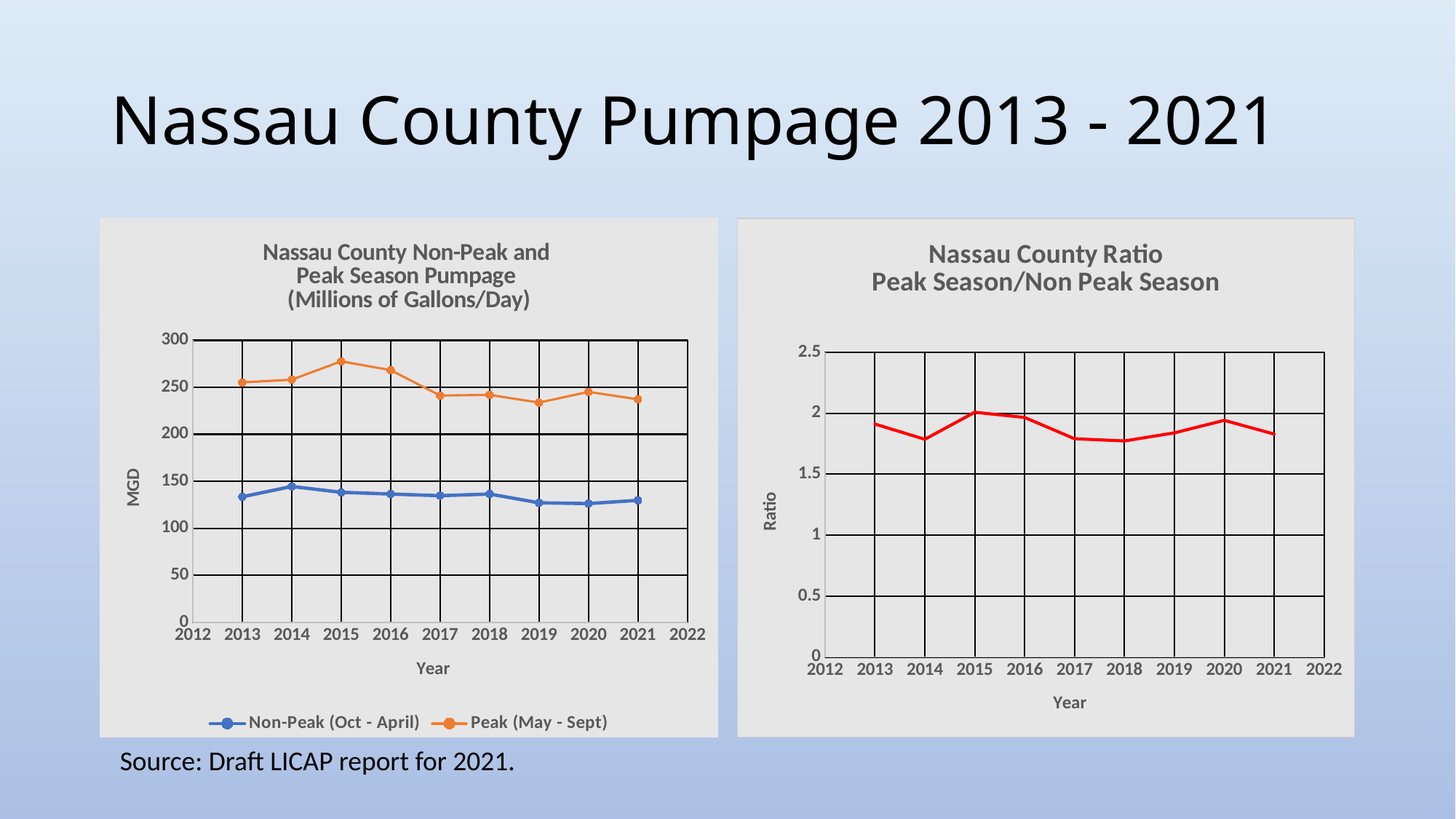
In the left chart, is the Peak (May - Sept) value for 2015 greater or less than 250? greater In the left chart, how many years are plotted for the Peak (May - Sept) series? 9 In the left chart, does the Peak (May - Sept) series overall rise or fall from 2013 to 2021? fall In the left chart, is the Non-Peak (Oct - April) value for 2013 greater or less than 150? less In the left chart, is the Peak (May - Sept) value for 2019 greater or less than 250? less In the left chart, which year has the highest Non-Peak (Oct - April) pumpage? 2014 In the left chart, which year has the highest Peak (May - Sept) pumpage? 2015 How many series does the legend of the left chart list? 2 What kind of chart is the left chart, 'Nassau County Non-Peak and Peak Season Pumpage'? line chart In the left chart, which series is larger in 2015, Peak (May - Sept) or Non-Peak (Oct - April)? Peak (May - Sept)